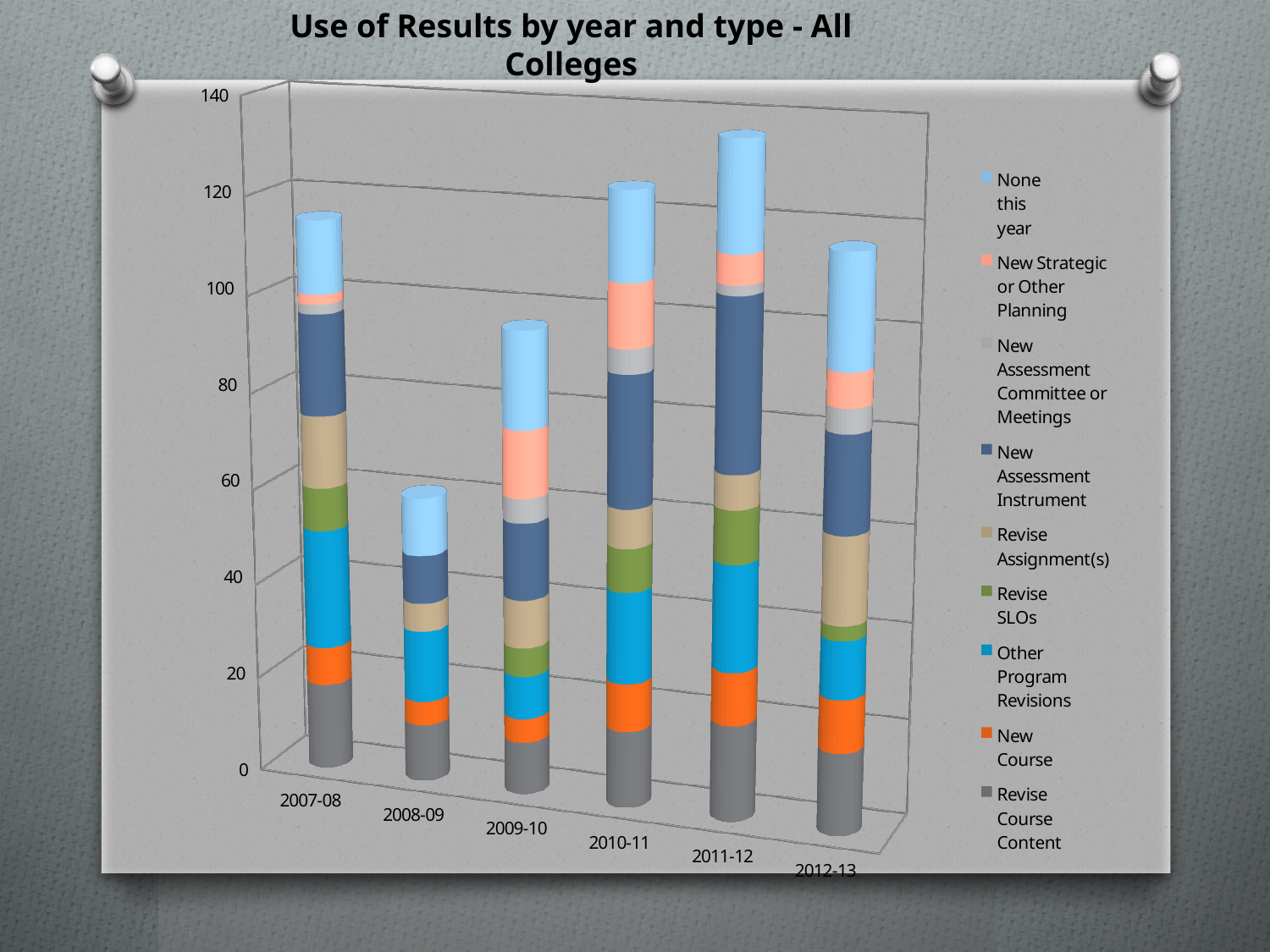
Which year has the tallest stacked bar? 2011-12 What kind of chart is shown on the slide? Stacked bar chart Is the total for 2011-12 greater or less than 100? greater How many years (categories) are shown along the x axis? 6 Which series is listed last (at the bottom) in the legend? Revise Course Content Which has the larger total, 2010-11 or 2008-09? 2010-11 Is the total for 2008-09 greater or less than 80? less Do the bar totals rise or fall from 2008-09 to 2011-12? rise Which year has the shortest stacked bar? 2008-09 How many series does the legend list? 9 What is the title of the chart? Use of Results by year and type - All Colleges